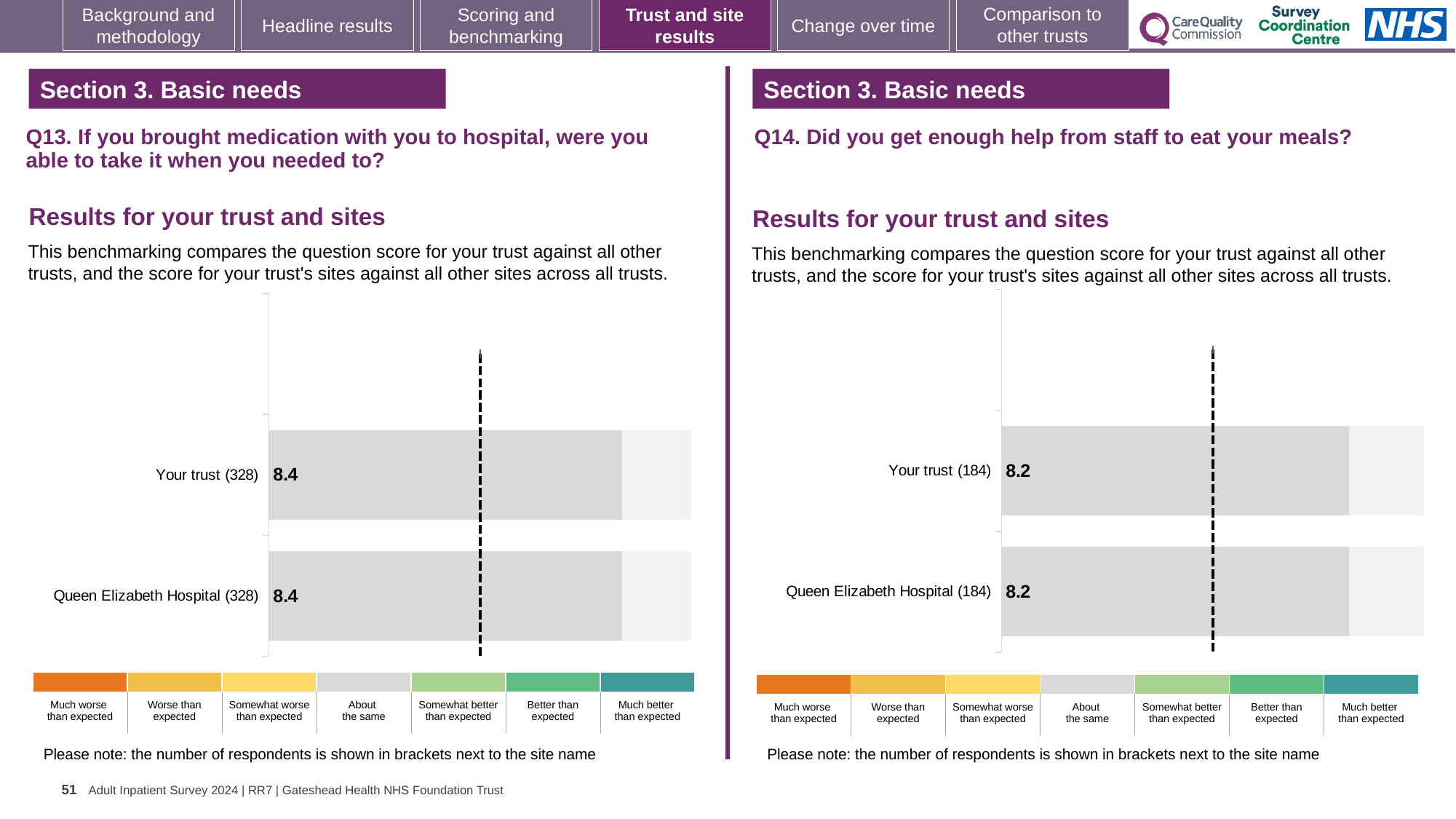
In the Q14 chart on the right, what is the score for Your trust? 8.2 In the Q14 chart on the right, what is the score for Queen Elizabeth Hospital? 8.2 How many bars are plotted in the Q14 chart on the right? 2 What is the question text shown above the chart on the right? Q14. Did you get enough help from staff to eat your meals? How many benchmark categories are listed in the colour key below the Q13 chart on the left? 7 In the Q13 chart on the left, how many respondents are shown in brackets next to Your trust? 328 How many bars are plotted in the Q13 chart on the left? 2 In the Q14 chart on the right, how many respondents are shown in brackets next to Queen Elizabeth Hospital? 184 In the Q13 chart on the left, what is the score for Queen Elizabeth Hospital? 8.4 What kind of chart is used for the Q14 results on the right? Bar chart In the Q13 chart on the left, what is the score for Your trust? 8.4 In the Q13 chart on the left, what is the difference between the score for Your trust and the score for Queen Elizabeth Hospital? 0